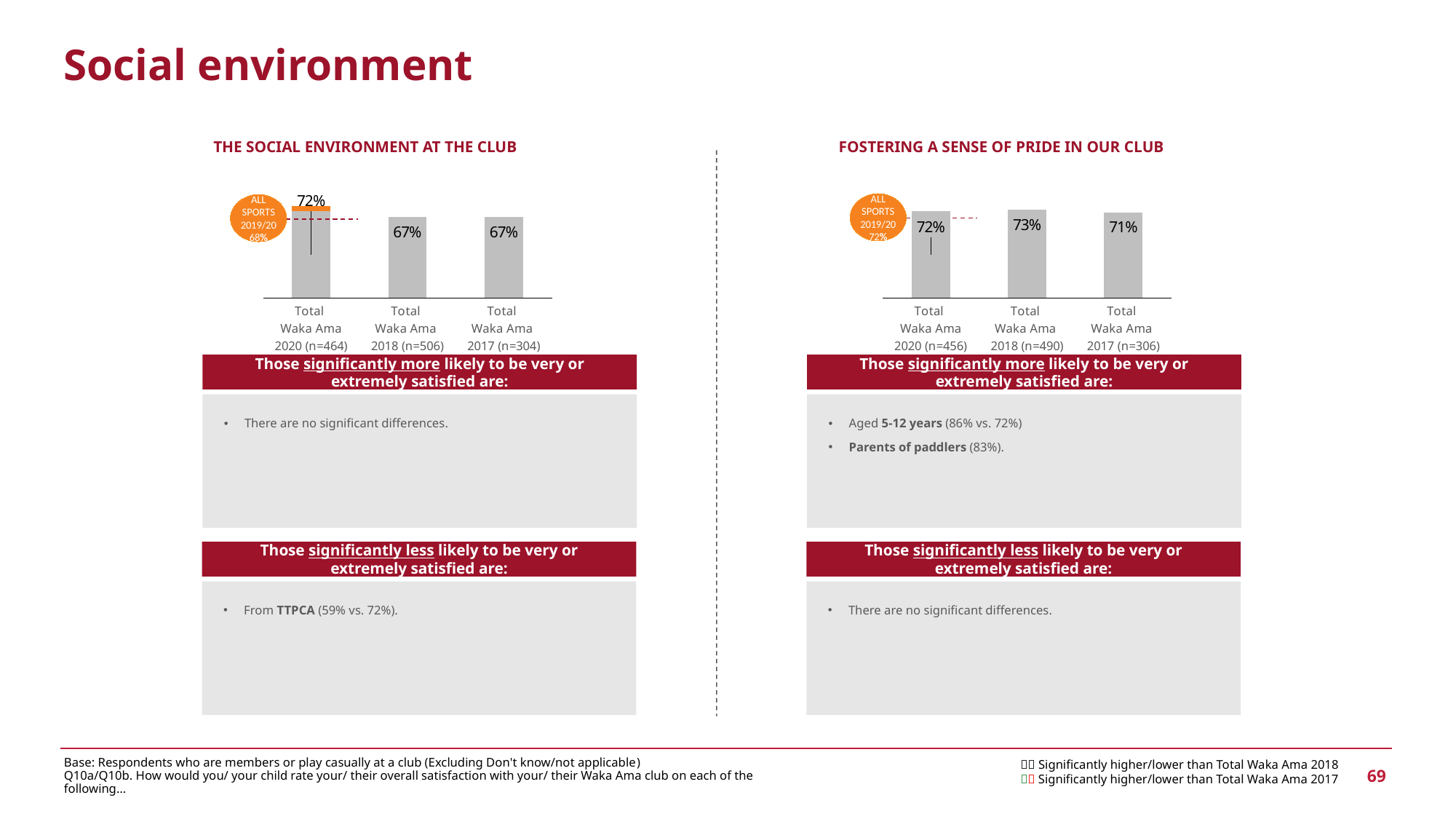
What type of chart is used in 'FOSTERING A SENSE OF PRIDE IN OUR CLUB'? Bar chart In the chart titled 'FOSTERING A SENSE OF PRIDE IN OUR CLUB', which year has the lowest value? Total Waka Ama 2017 In the chart titled 'FOSTERING A SENSE OF PRIDE IN OUR CLUB', what is the value for Total Waka Ama 2018? 73% In the chart titled 'THE SOCIAL ENVIRONMENT AT THE CLUB', what is the value for Total Waka Ama 2020? 72% In the chart titled 'THE SOCIAL ENVIRONMENT AT THE CLUB', how many bars are plotted? 3 In the chart titled 'FOSTERING A SENSE OF PRIDE IN OUR CLUB', what is the difference between the 2018 value and the 2017 value? 2 percentage points In the chart titled 'THE SOCIAL ENVIRONMENT AT THE CLUB', what is the sample size (n) for Total Waka Ama 2020? n=464 In the chart titled 'THE SOCIAL ENVIRONMENT AT THE CLUB', what is the value for Total Waka Ama 2018? 67% In the chart titled 'FOSTERING A SENSE OF PRIDE IN OUR CLUB', what is the value for Total Waka Ama 2017? 71% In the chart titled 'THE SOCIAL ENVIRONMENT AT THE CLUB', what is the difference between the 2020 value and the 2018 value? 5 percentage points In the chart titled 'FOSTERING A SENSE OF PRIDE IN OUR CLUB', what is the ALL SPORTS 2019/20 benchmark value shown in the orange circle? 72% In the chart titled 'THE SOCIAL ENVIRONMENT AT THE CLUB', which year has the highest value? Total Waka Ama 2020